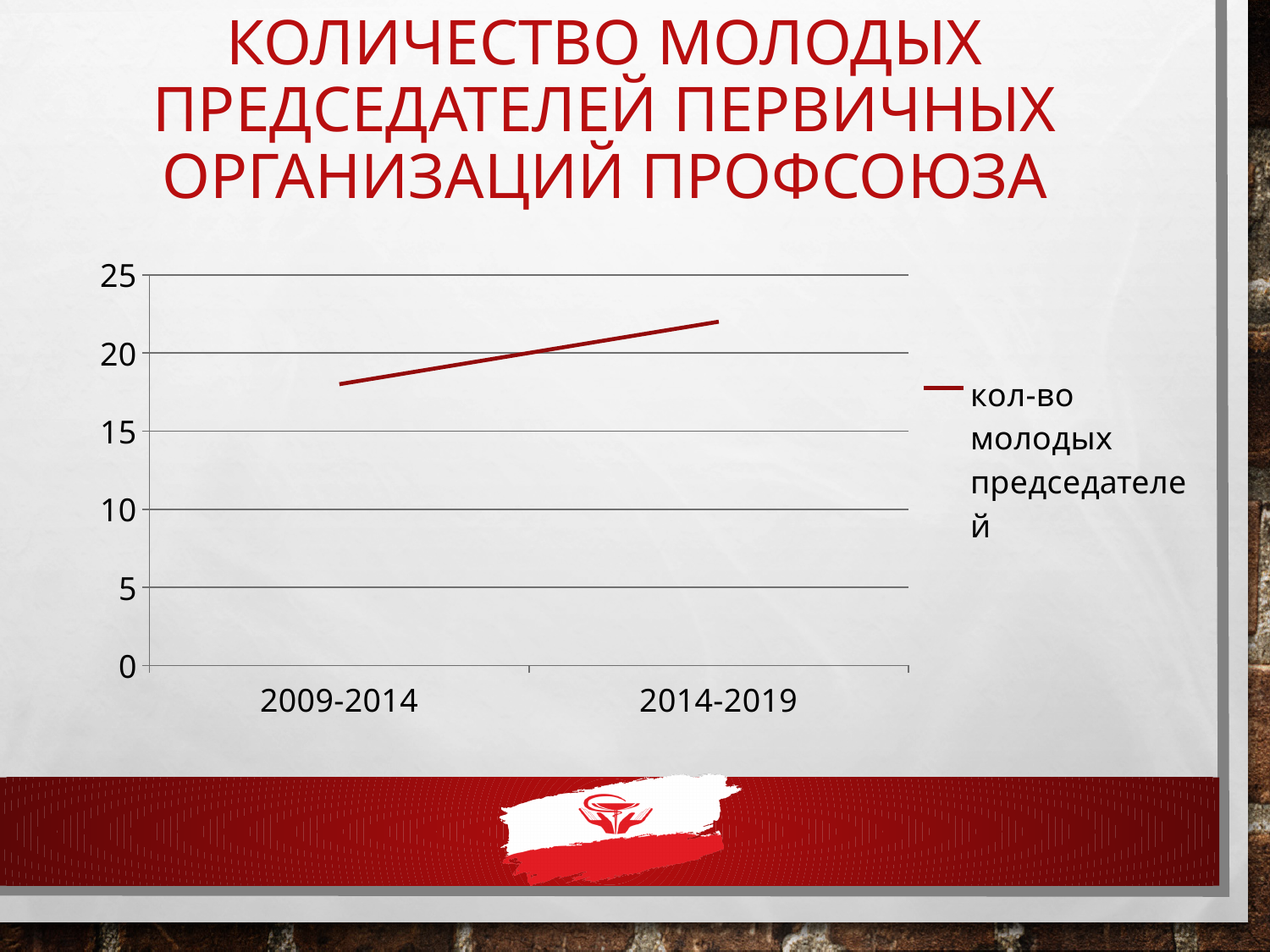
What is the name of the series shown in the legend? кол-во молодых председателей Which period has the lowest value? 2009-2014 What is the maximum value shown on the y axis? 25 Do the values rise or fall from 2009-2014 to 2014-2019? rise Is the value for 2014-2019 greater or less than 20? greater How many series does the legend list? 1 Is the value for 2009-2014 greater or less than 20? less Which period has the higher value, 2009-2014 or 2014-2019? 2014-2019 Is the value for 2014-2019 greater or less than 25? less What kind of chart is shown on the slide? line chart How many periods are plotted along the x axis? 2